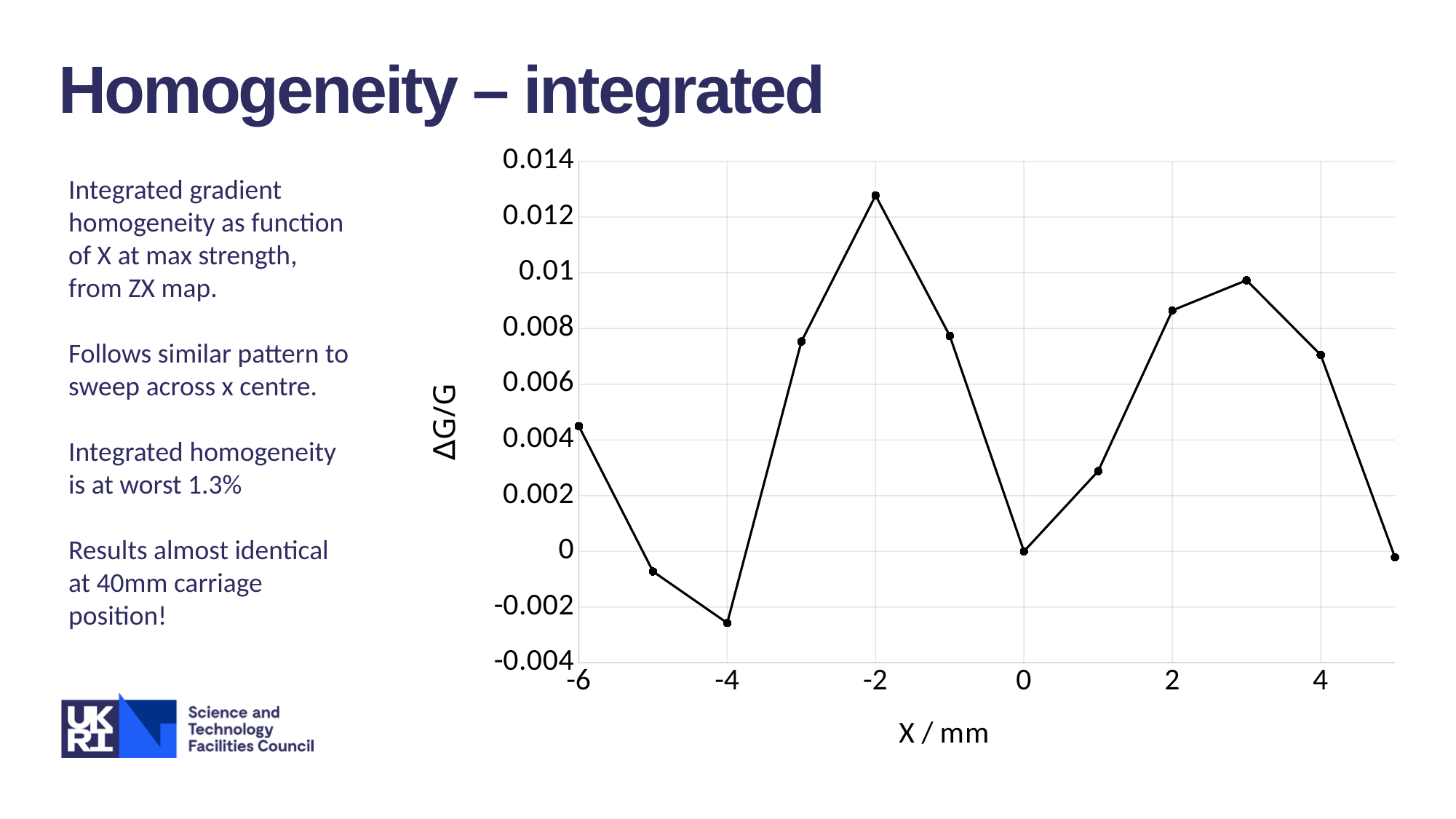
Is the value of ΔG/G at X = 2 greater or less than 0.008? greater Which has the larger ΔG/G value: X = -2 or X = 3? X = -2 At which X value does ΔG/G reach its lowest point? -4 Which has the larger ΔG/G value: X = -4 or X = -5? X = -5 Is the value of ΔG/G at X = -2 greater or less than 0.012? greater Is the value of ΔG/G at X = -4 greater or less than -0.002? less What kind of chart is shown on the slide? Line chart Does ΔG/G rise or fall as X goes from -4 to -2? rise What is the label on the x axis of the chart? X / mm How many data points are plotted on the chart? 12 At which X value does ΔG/G reach its highest point? -2